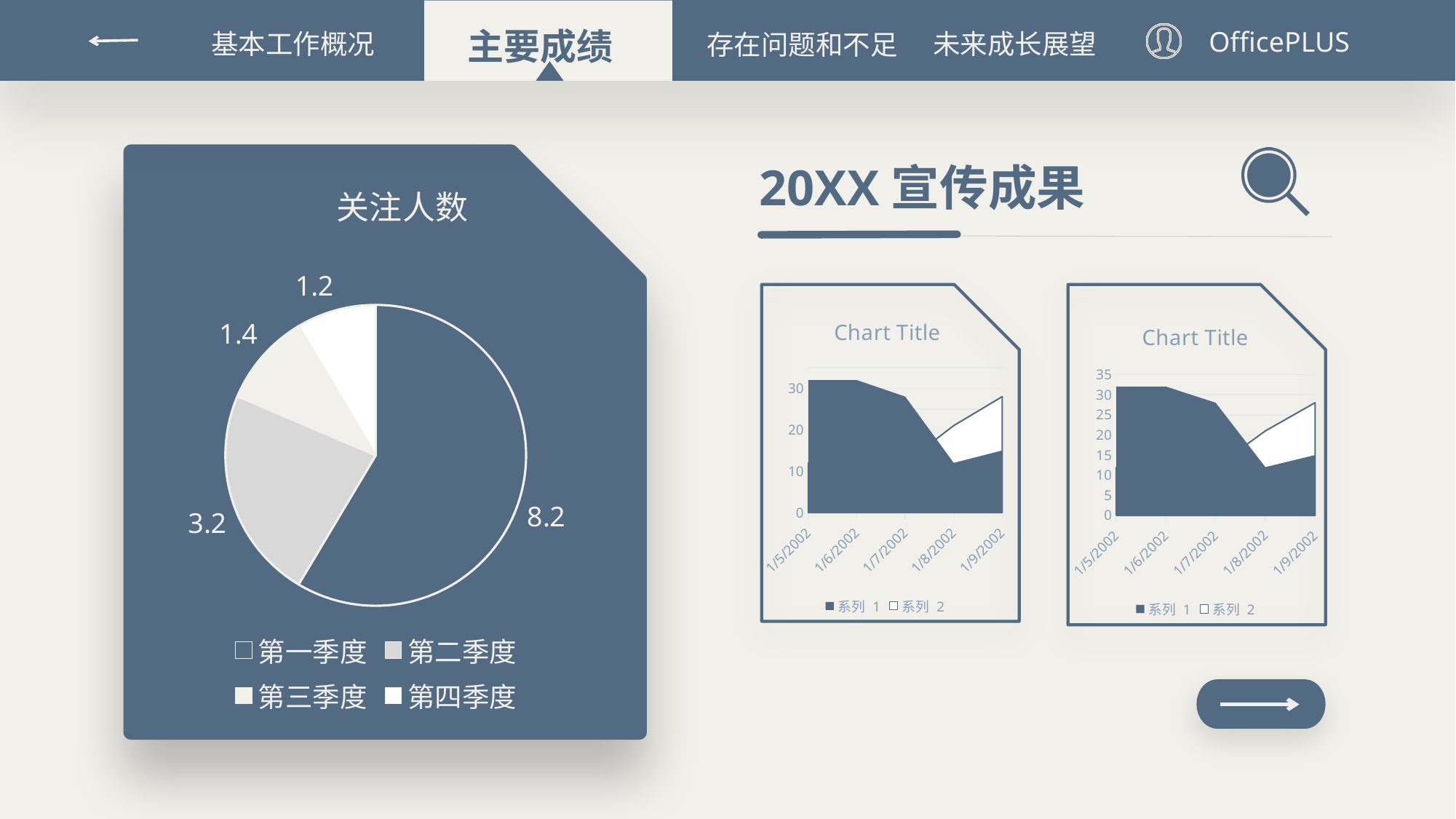
In the right-hand Chart Title chart, does 系列 1 rise or fall from 1/5/2002 to 1/8/2002? fall What type of chart are the two charts titled Chart Title on the right of the slide? area chart In the 关注人数 pie chart, what is the value for 第二季度? 3.2 In the left-hand Chart Title chart, is the value of 系列 1 at 1/5/2002 greater or less than 30? greater In the 关注人数 pie chart, how many slices are there? 4 In the 关注人数 pie chart, what is the value for 第一季度? 8.2 In the 关注人数 pie chart, what is the difference between the values for 第一季度 and 第二季度? 5.0 In the 关注人数 pie chart, what is the value for 第四季度? 1.2 In the 关注人数 pie chart, which quarter has the smallest slice? 第四季度 What type of chart is the 关注人数 chart on the left of the slide? pie chart In the 关注人数 pie chart, which quarter has the largest slice? 第一季度 How many series does the legend of the left-hand Chart Title area chart list? 2